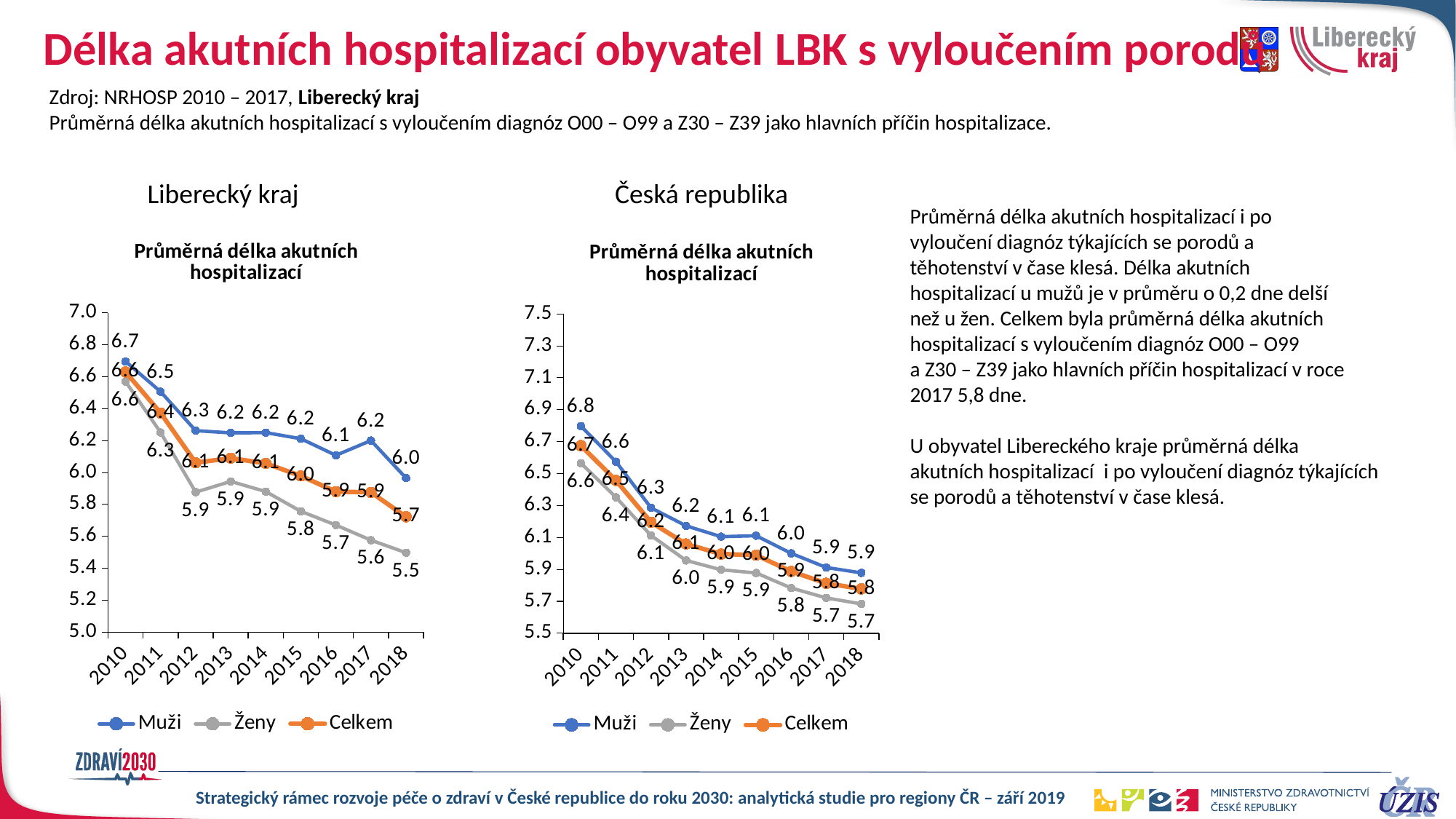
In the Liberecký kraj chart, what is the value for Ženy in 2018? 5.5 In the Česká republika chart, which is larger in 2012: Muži or Ženy? Muži In the Česká republika chart, what is the value for Celkem in 2010? 6.7 In the Česká republika chart, does the Celkem series generally rise or fall from 2010 to 2018? Fall What kind of chart is the Liberecký kraj chart? Line chart In the Česká republika chart, in which year is the Muži series highest? 2010 In the Liberecký kraj chart, in which year is the Ženy series lowest? 2018 In the Liberecký kraj chart, what is the difference between Muži and Ženy in 2018? 0.5 How many years are shown on the x axis of the Liberecký kraj chart? 9 How many series does the legend of the Česká republika chart list? 3 In the Liberecký kraj chart, what is the value for Muži in 2010? 6.7 In the Česká republika chart, what is the value for Muži in 2018? 5.9